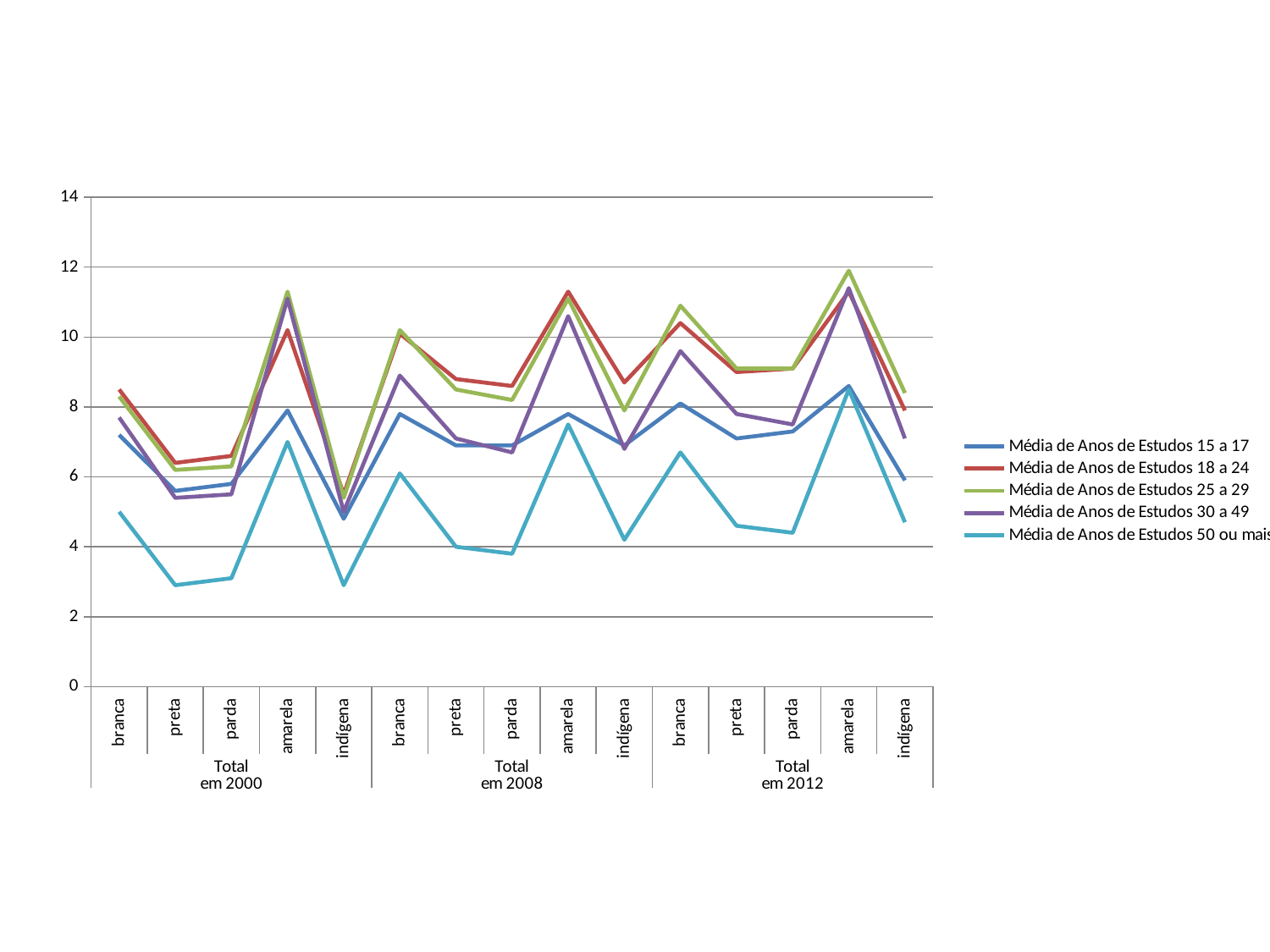
Is the value of Média de Anos de Estudos 50 ou mais for preta in Total em 2000 greater or less than 4? less Which series is shown in light blue in the legend? Média de Anos de Estudos 50 ou mais Within Total em 2000, which category has the highest value for Média de Anos de Estudos 25 a 29? amarela Which three year groups are shown on the x axis? Total em 2000, Total em 2008, Total em 2012 Is the value of Média de Anos de Estudos 15 a 17 for indígena in Total em 2000 greater or less than 6? less Is the value of Média de Anos de Estudos 25 a 29 for amarela in Total em 2012 greater or less than 10? greater How many categories are plotted along the x axis? 15 Which series has the lowest values across all categories? Média de Anos de Estudos 50 ou mais Within Total em 2000, which category has the lowest value for Média de Anos de Estudos 15 a 17? indígena How many series does the legend list? 5 What kind of chart is shown on the slide? line chart